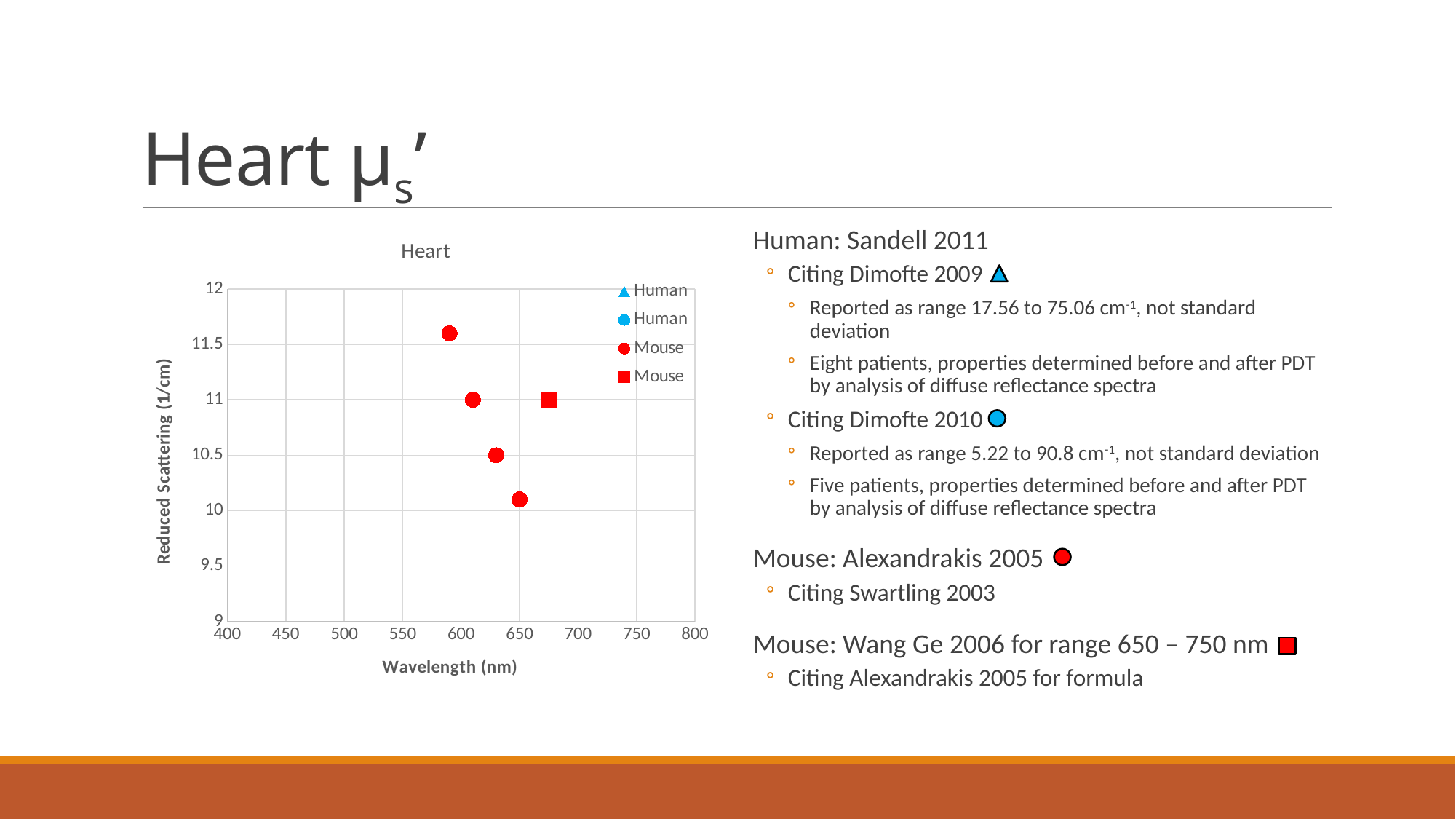
Is the wavelength of the Mouse square point greater or less than 650 nm? greater What kind of chart is shown on the slide? scatter chart What is the title of the chart? Heart Which series has the lowest plotted reduced scattering value on the chart? Mouse (circle) Is the reduced scattering value of the Mouse circle point at 650 nm greater or less than 10.5? less Do the Mouse circle points rise or fall as wavelength increases? fall How many data points are plotted on the chart? 5 How many series does the chart legend list? 4 Is the reduced scattering value of the Mouse square point greater or less than 10.5? greater Which plotted point has the highest reduced scattering value: the Mouse circle near 590 nm or the Mouse circle at 650 nm? the Mouse circle near 590 nm What is the label of the y axis? Reduced Scattering (1/cm)